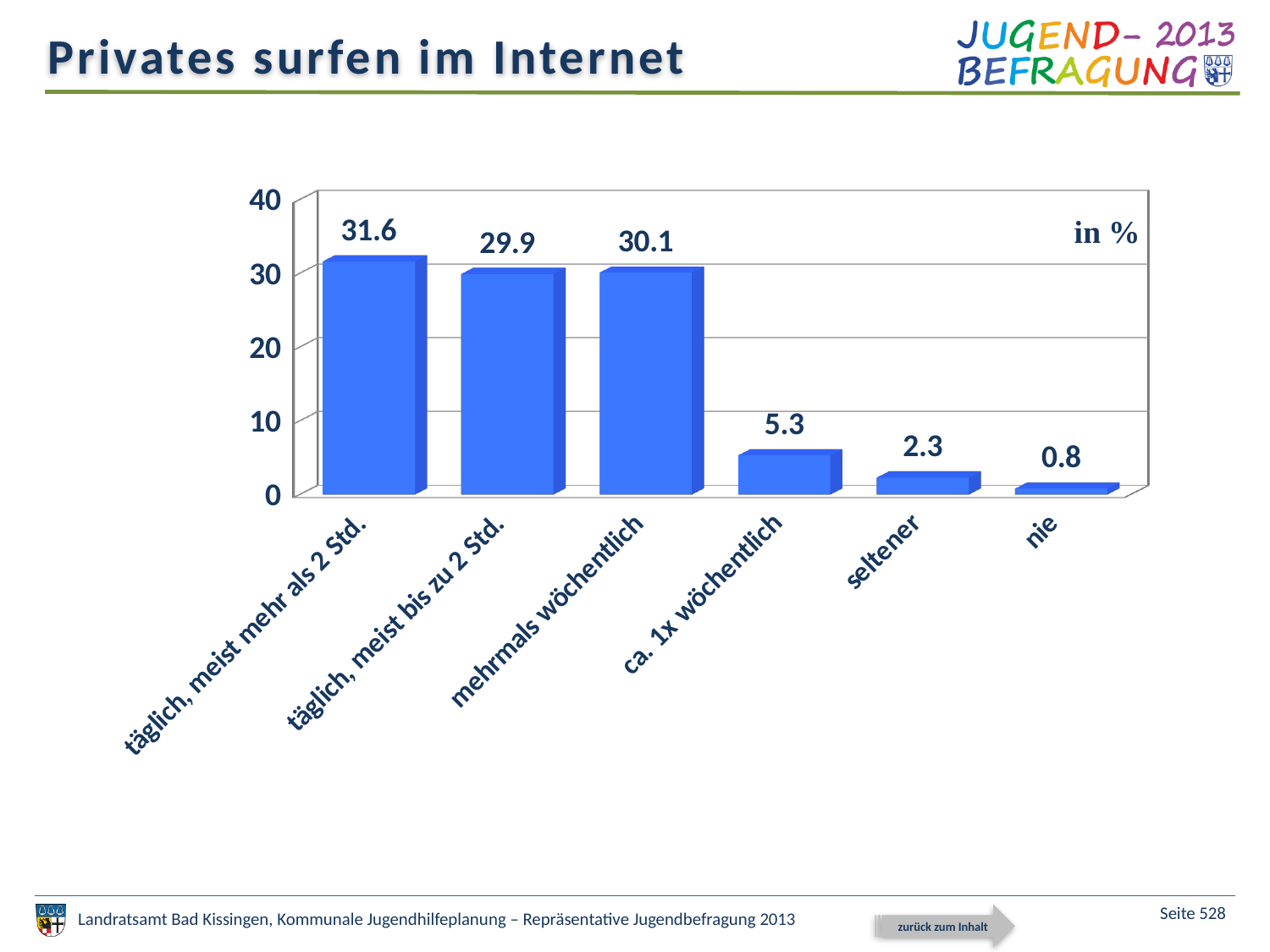
What is the value for "täglich, meist mehr als 2 Std."? 31.6 Which is larger, the value for "mehrmals wöchentlich" or the value for "täglich, meist bis zu 2 Std."? mehrmals wöchentlich What is the difference between the values for "ca. 1x wöchentlich" and "seltener"? 3.0 How many categories are shown on the x axis? 6 What unit is indicated in the top right corner of the chart? in % Which category has the highest value? täglich, meist mehr als 2 Std. What is the value for "mehrmals wöchentlich"? 30.1 What is the value for "nie"? 0.8 What kind of chart is shown on the slide? bar chart What is the difference between the values for "täglich, meist mehr als 2 Std." and "täglich, meist bis zu 2 Std."? 1.7 What is the value for "seltener"? 2.3 Which category has the lowest value? nie